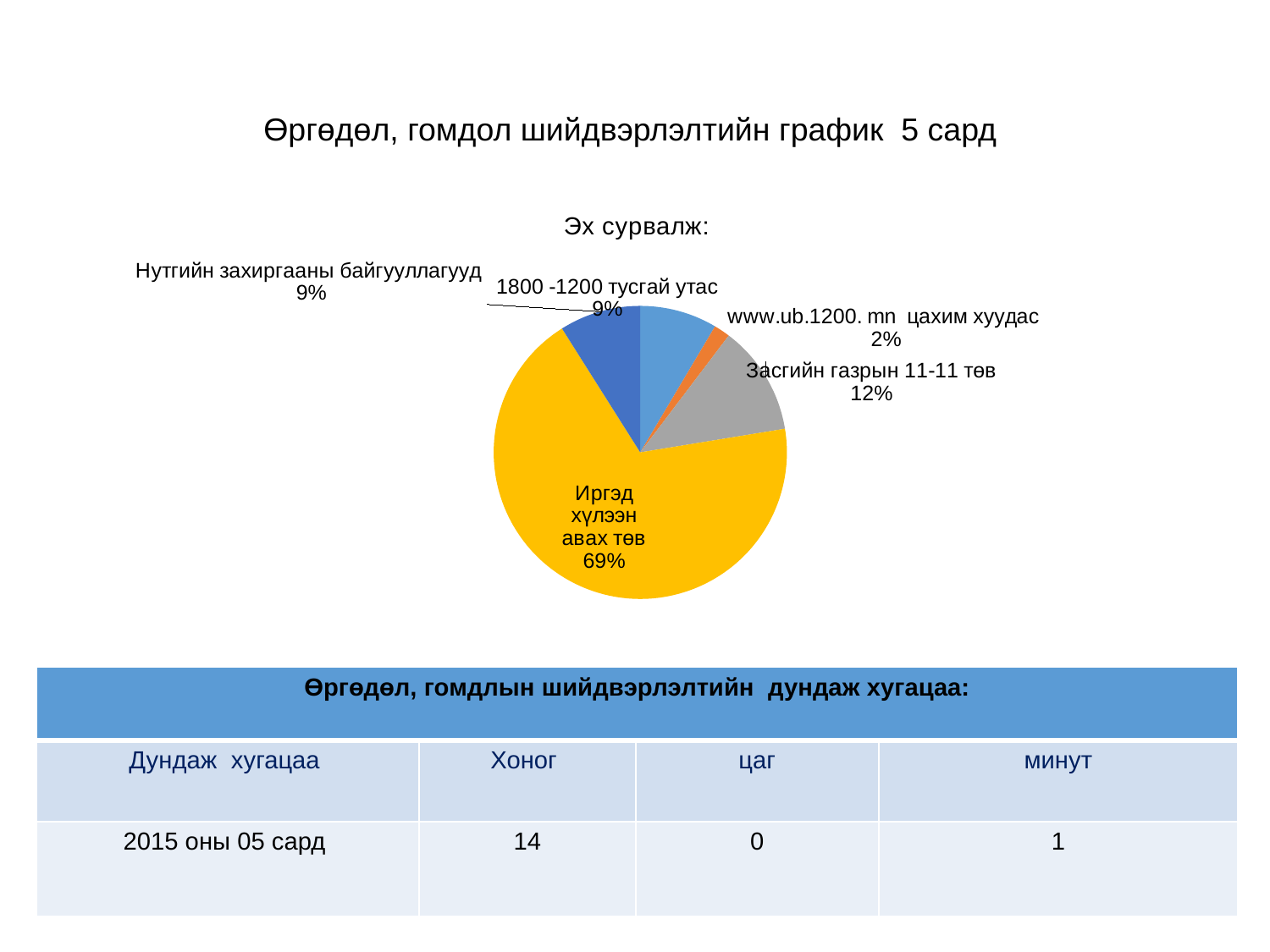
What share of the pie does Иргэд хүлээн авах төв have? 69% What is the title of the chart? Эх сурвалж: What share of the pie does Засгийн газрын 11-11 төв have? 12% What colour is the slice for Иргэд хүлээн авах төв? yellow How many slices does the pie chart have? 5 Which category has the smallest slice of the pie? www.ub.1200. mn цахим хуудас What share of the pie does www.ub.1200. mn цахим хуудас have? 2% Which is larger, the share for Засгийн газрын 11-11 төв or the share for Нутгийн захиргааны байгууллагууд? Засгийн газрын 11-11 төв What kind of chart is shown on the slide? pie chart Which category has the largest slice of the pie? Иргэд хүлээн авах төв What is the difference in percentage points between Иргэд хүлээн авах төв and Засгийн газрын 11-11 төв? 57